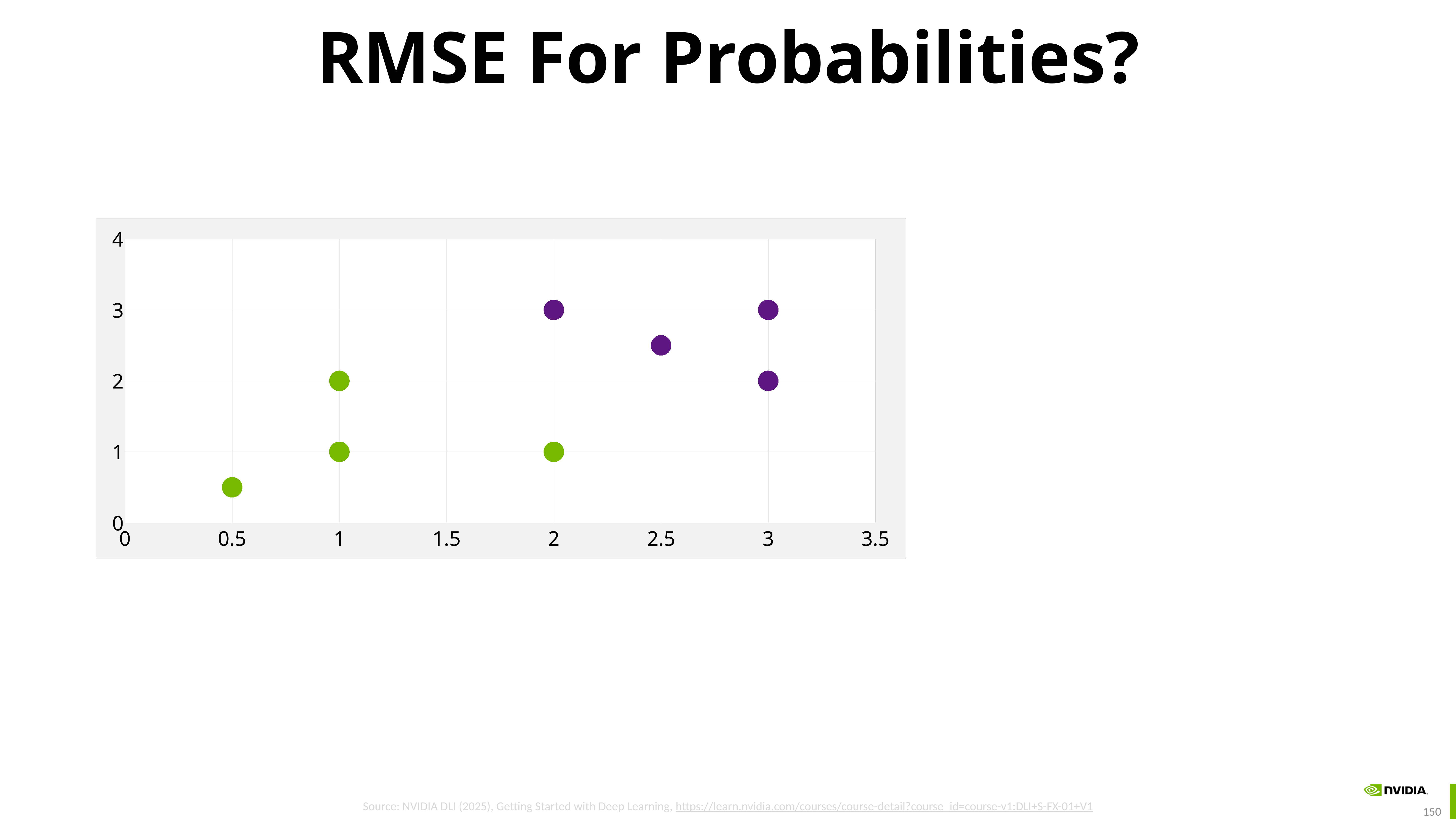
What is the y value of the purple point at x = 2? 3 Is the y value of the purple point at x = 2.5 greater or less than 2? greater At x = 2, which point is higher, the purple one or the green one? purple What kind of chart is shown on the slide? scatter chart How many green points are plotted in the chart? 4 How many data points are plotted in the chart? 8 What two colours are used for the points in the chart? green and purple Is the y value of the green point at x = 0.5 greater or less than 1? less What is the title of the slide containing the chart? RMSE For Probabilities? How many purple points are plotted in the chart? 4 What is the difference in y value between the purple point and the green point at x = 2? 2 What is the y value of the green point at x = 2? 1